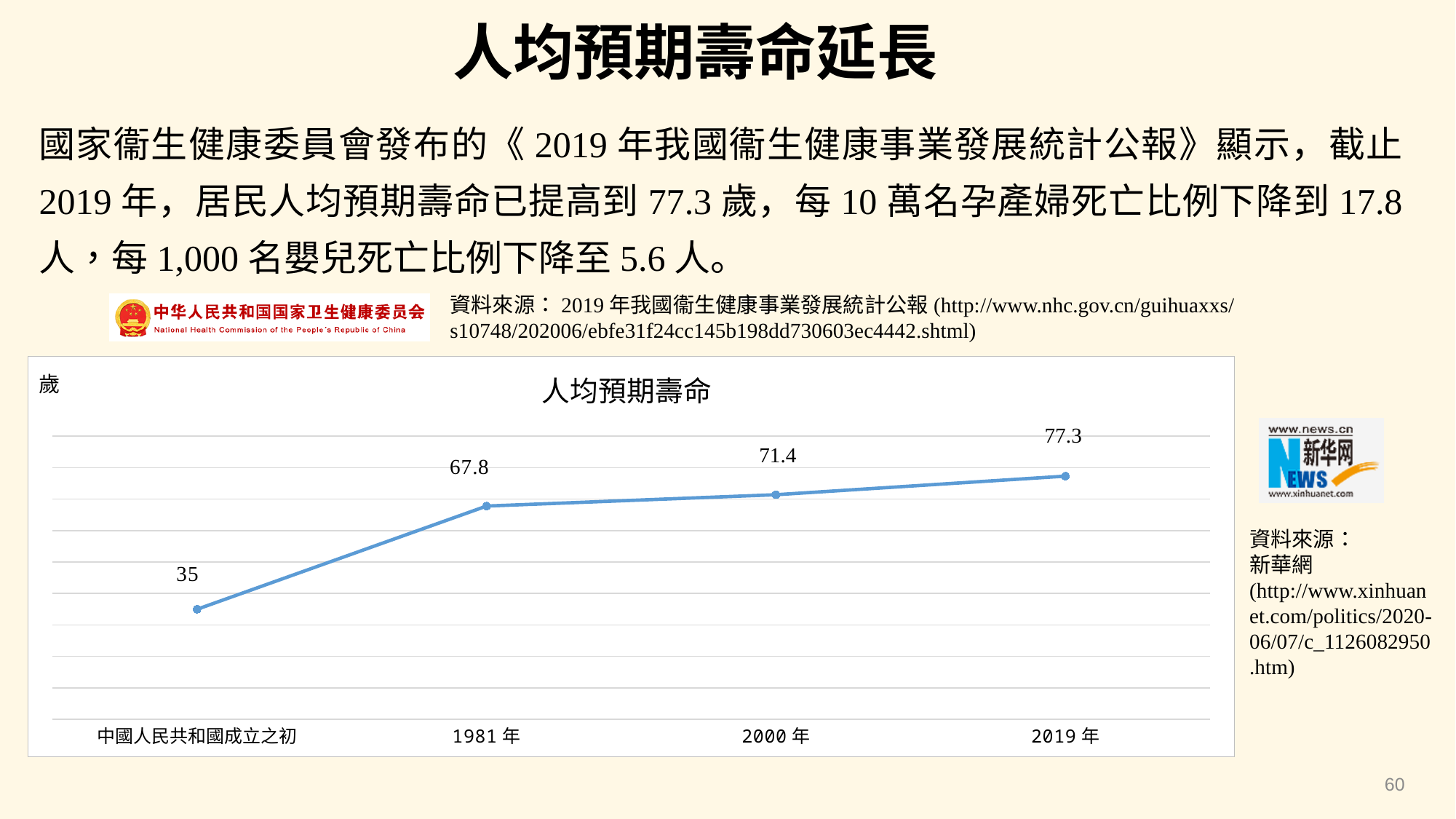
Which category has the lowest value in the 人均預期壽命 chart? 中國人民共和國成立之初 What is the value for 中國人民共和國成立之初 in the 人均預期壽命 chart? 35 What is the value for 2000年 in the 人均預期壽命 chart? 71.4 Do the values in the 人均預期壽命 chart rise or fall along the x axis? rise What is the value for 2019年 in the 人均預期壽命 chart? 77.3 What is the difference between the values for 2019年 and 中國人民共和國成立之初 in the 人均預期壽命 chart? 42.3 Which is larger in the 人均預期壽命 chart, the value for 1981年 or the value for 2000年? 2000年 What is the value for 1981年 in the 人均預期壽命 chart? 67.8 Which category has the highest value in the 人均預期壽命 chart? 2019年 What is the difference between the values for 2000年 and 1981年 in the 人均預期壽命 chart? 3.6 How many data points are plotted in the 人均預期壽命 chart? 4 What kind of chart is the 人均預期壽命 chart? line chart